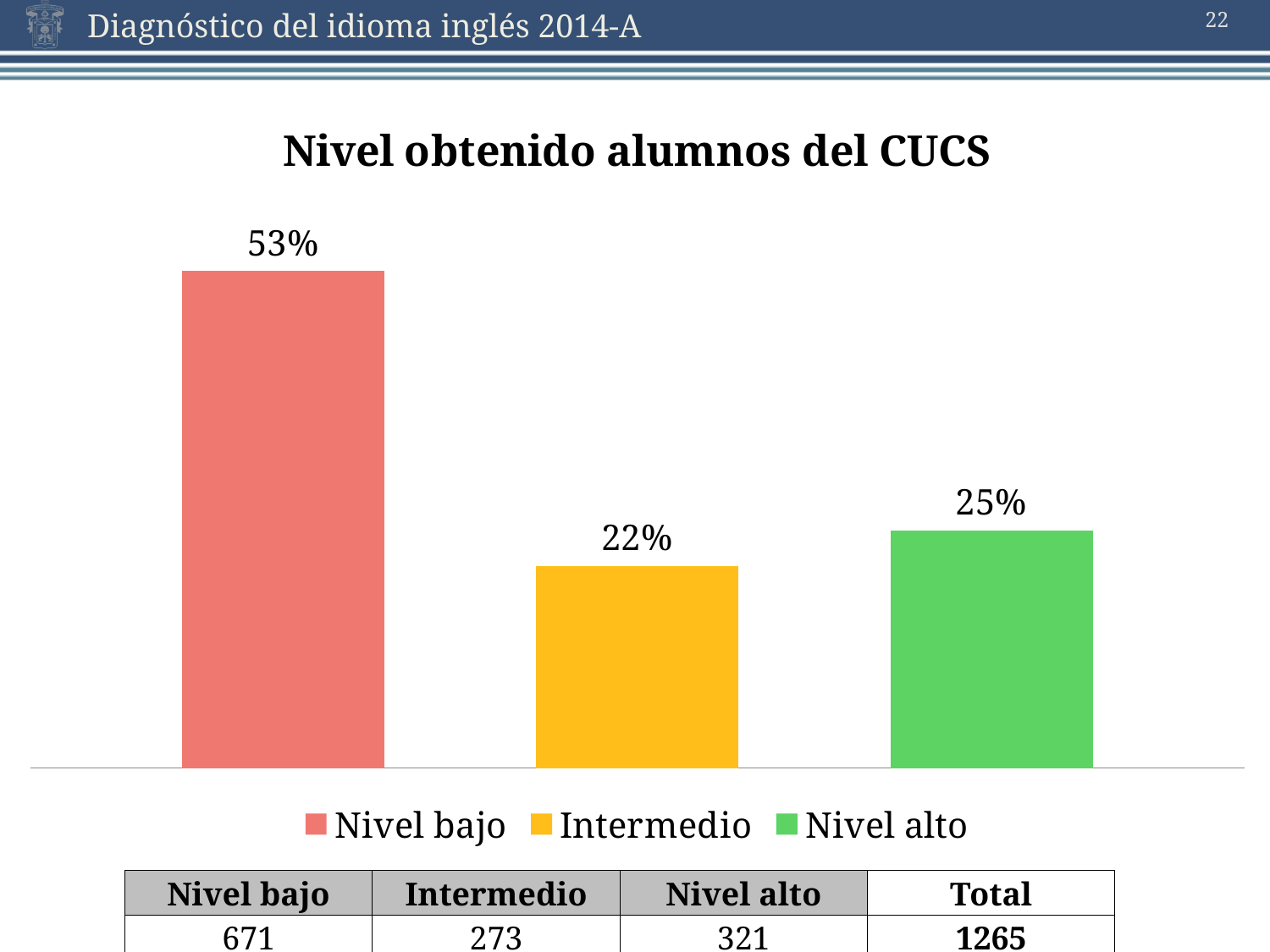
How many bars are shown in the chart? 3 How many entries does the legend list? 3 Which is larger, the percentage for Nivel alto or for Intermedio? Nivel alto What percentage is shown for Intermedio? 22% What percentage is shown for Nivel bajo? 53% What is the difference in percentage points between Nivel alto and Intermedio? 3 What percentage is shown for Nivel alto? 25% What is the difference in percentage points between Nivel bajo and Nivel alto? 28 What is the title of the chart? Nivel obtenido alumnos del CUCS Which level has the lowest percentage? Intermedio Which level has the highest percentage? Nivel bajo What type of chart is shown on the slide? Bar chart